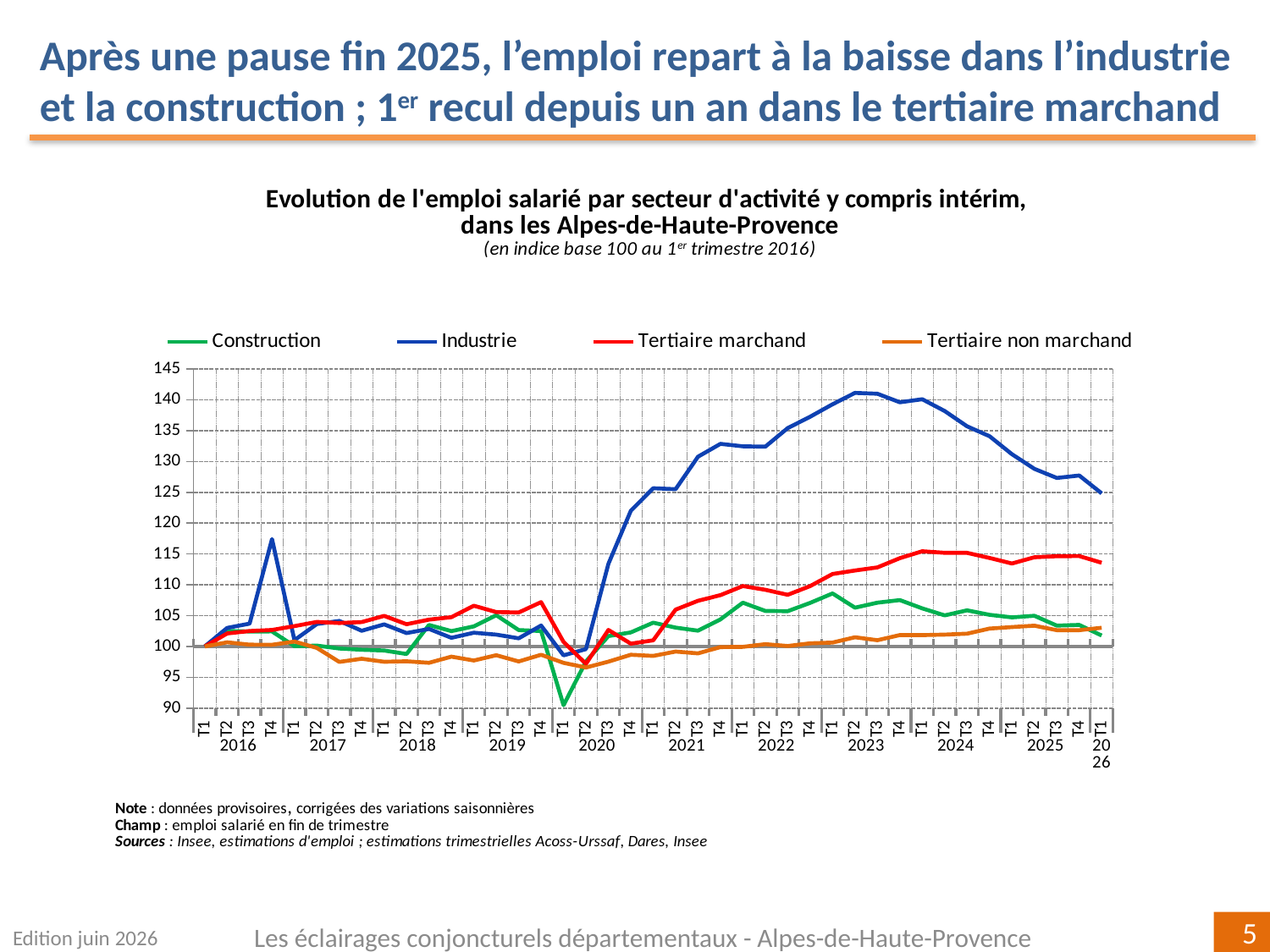
Which series has the lowest value at T1 2020? Construction Which series has the highest value at T1 2026? Industrie How many series does the legend list? 4 Does the Industrie series rise or fall between T1 2023 and T1 2026? fall At T1 2026, which is larger: Industrie or Tertiaire marchand? Industrie Is the value for Tertiaire marchand at T1 2024 greater or less than 110? greater Is the value for Construction at T1 2020 greater or less than 95? less What kind of chart is shown on the slide? line chart Is the value for Industrie at T2 2023 greater or less than 135? greater What is the base period of the index used in the chart? 1er trimestre 2016 (base 100) Does the Tertiaire marchand series rise or fall between T2 2020 and T1 2024? rise